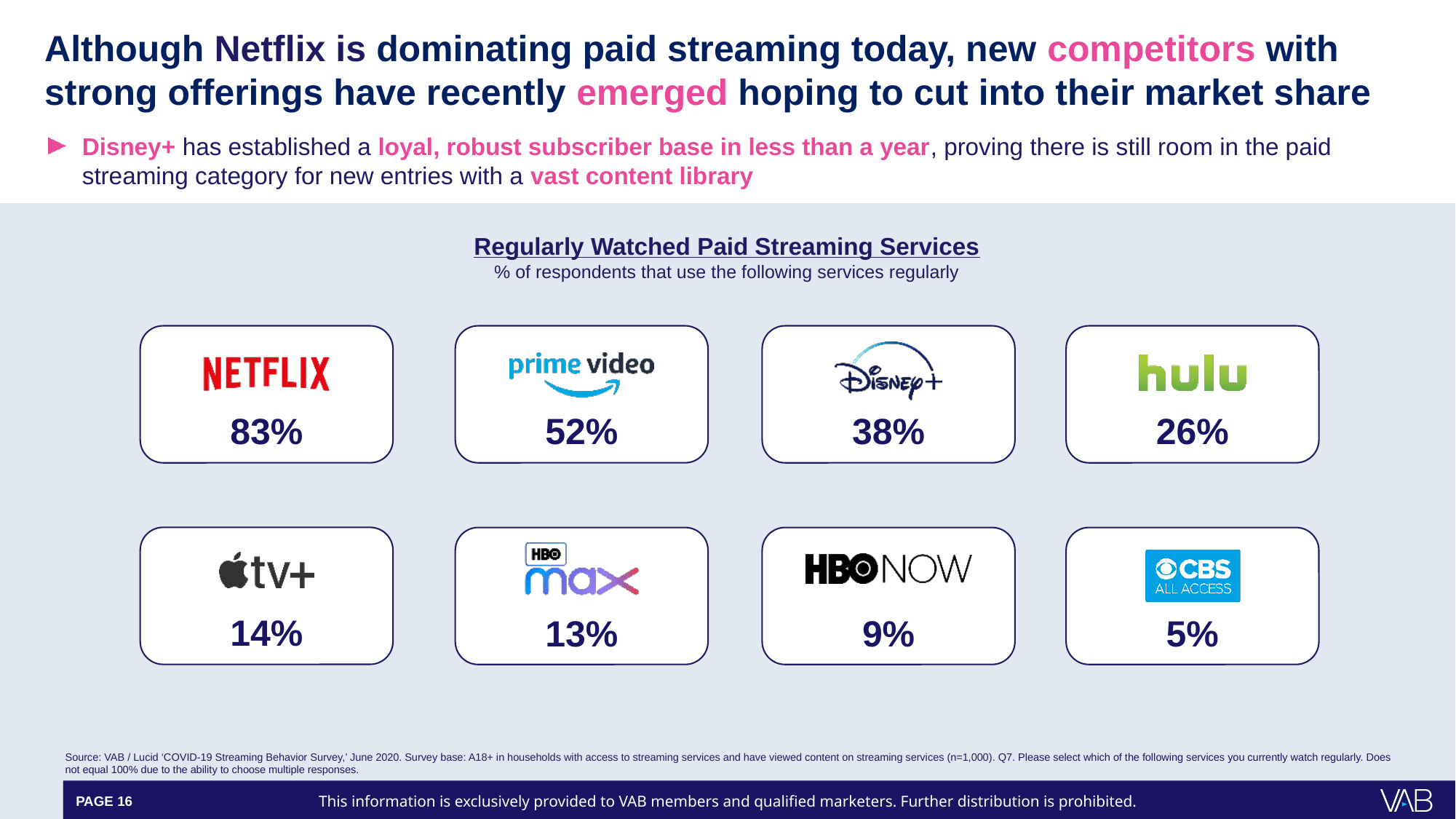
How many paid streaming services are shown in the Regularly Watched Paid Streaming Services display? 8 What percentage of respondents regularly watch Prime Video? 52% What is the title of the data display on the slide? Regularly Watched Paid Streaming Services Which has a higher share of regular viewers, Disney+ or Hulu? Disney+ What percentage of respondents regularly watch Netflix? 83% What percentage of respondents regularly watch Hulu? 26% What is the difference in percentage points between Apple TV+ and HBO Max? 1 Which paid streaming service has the lowest share of respondents watching it regularly? CBS All Access What is the difference in percentage points between Netflix and Prime Video? 31 What percentage of respondents regularly watch Disney+? 38% What percentage of respondents regularly watch CBS All Access? 5% Which paid streaming service has the highest share of respondents watching it regularly? Netflix